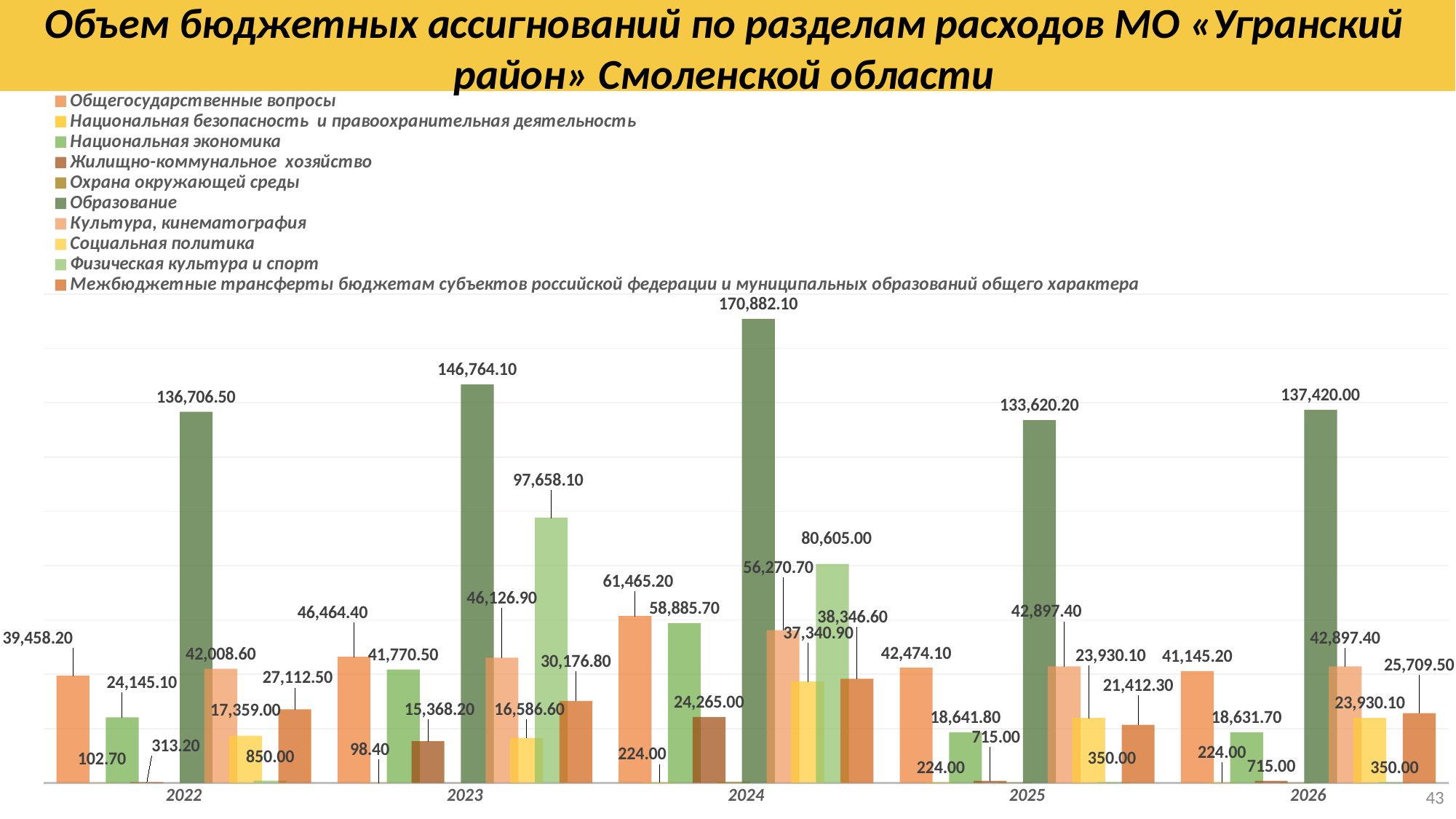
What is the value for Образование in 2024? 170,882.10 In 2024, which is larger: Общегосударственные вопросы or Национальная экономика? Общегосударственные вопросы What kind of chart is shown on the slide? Bar chart Does the value for Общегосударственные вопросы rise or fall from 2024 to 2026? Fall What is the value for Физическая культура и спорт in 2023? 97,658.10 What is the value for Межбюджетные трансферты бюджетам субъектов российской федерации и муниципальных образований общего характера in 2026? 25,709.50 In which year is the value for Образование the highest? 2024 How many years are shown along the x axis? 5 What is the difference between the Образование values for 2024 and 2023? 24,118.00 What is the difference between the Физическая культура и спорт values for 2023 and 2024? 17,053.10 In which year is the value for Образование the lowest? 2025 How many series does the legend list? 10